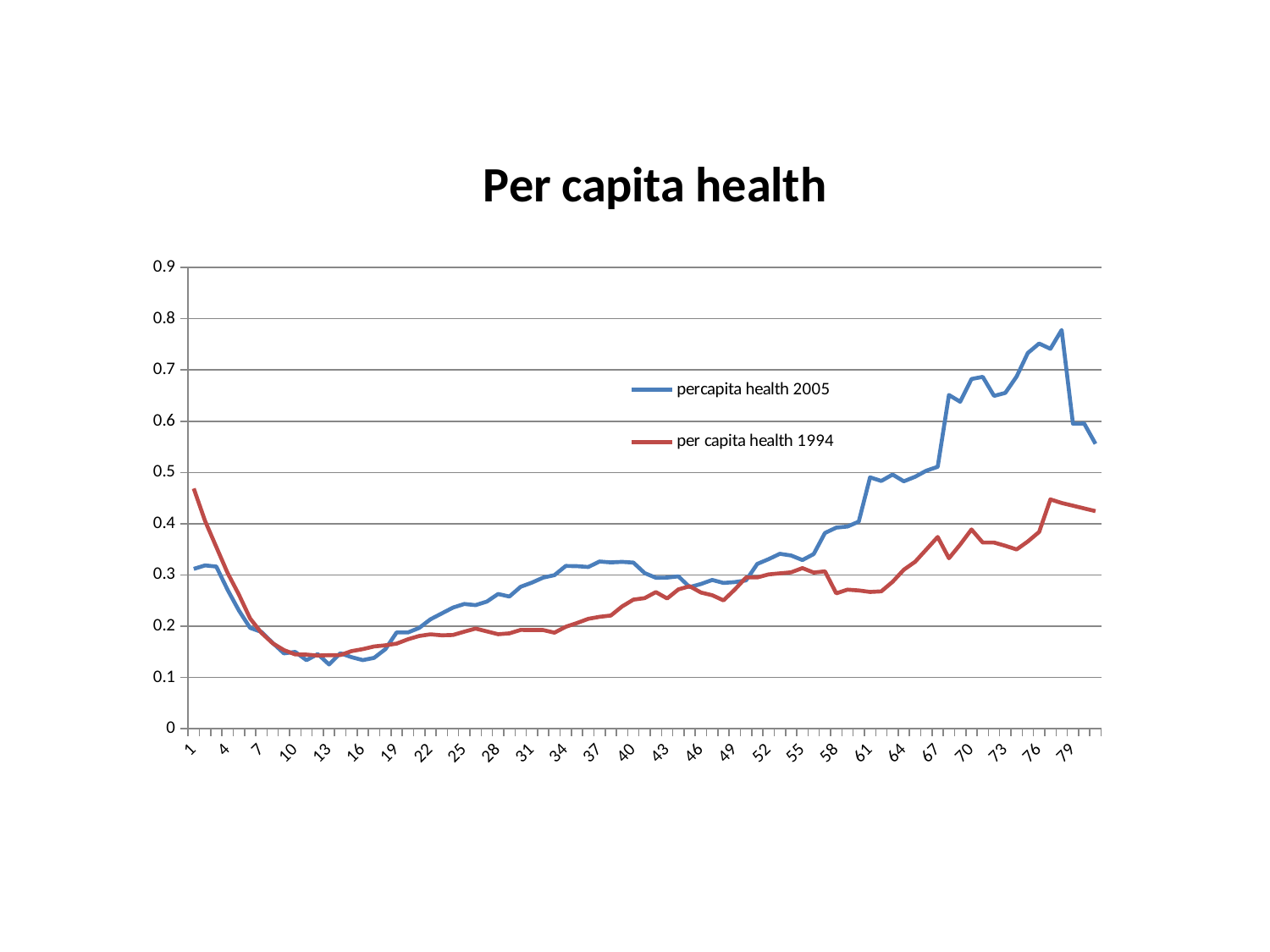
Is the value for per capita health 1994 at x = 13 greater or less than 0.2? less At x = 1, which series has the higher value? per capita health 1994 What is the title of the chart? Per capita health At x = 70, which series has the higher value? percapita health 2005 Which series reaches the higher peak value on the chart? percapita health 2005 Is the highest value of per capita health 1994 greater or less than 0.5? less Which series is drawn in blue? percapita health 2005 Is the highest value of percapita health 2005 greater or less than 0.7? greater What kind of chart is shown on the slide? line chart Does percapita health 2005 generally rise or fall between x = 19 and x = 37? rise How many series does the legend list? 2